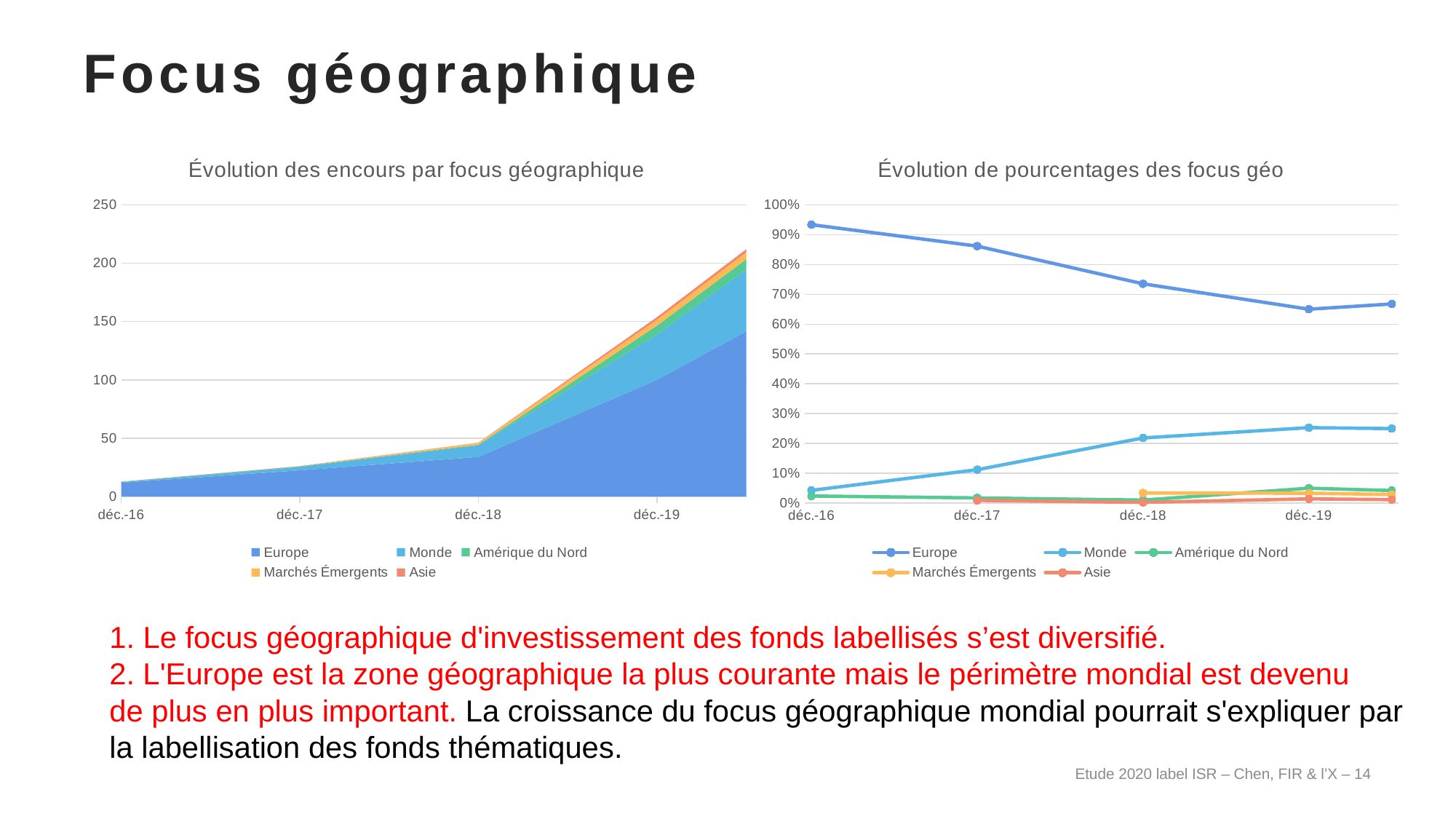
How many series does the legend of the left chart 'Évolution des encours par focus géographique' list? 5 How many series does the legend of the right chart 'Évolution de pourcentages des focus géo' list? 5 In the right chart 'Évolution de pourcentages des focus géo', which series has the highest value at déc.-16? Europe In the right chart 'Évolution de pourcentages des focus géo', is the value for Europe at déc.-19 greater or less than 70%? less What kind of chart is the left chart, 'Évolution des encours par focus géographique'? stacked area chart In the right chart 'Évolution de pourcentages des focus géo', which is larger at déc.-19, Europe or Monde? Europe In the right chart 'Évolution de pourcentages des focus géo', does the Europe line rise or fall from déc.-16 to déc.-19? fall In the right chart 'Évolution de pourcentages des focus géo', is the value for Europe at déc.-16 greater or less than 90%? greater In the left chart 'Évolution des encours par focus géographique', is the value for Europe at déc.-18 greater or less than 50? less What kind of chart is the right chart, 'Évolution de pourcentages des focus géo'? line chart In the right chart 'Évolution de pourcentages des focus géo', does the Monde line rise or fall from déc.-16 to déc.-19? rise